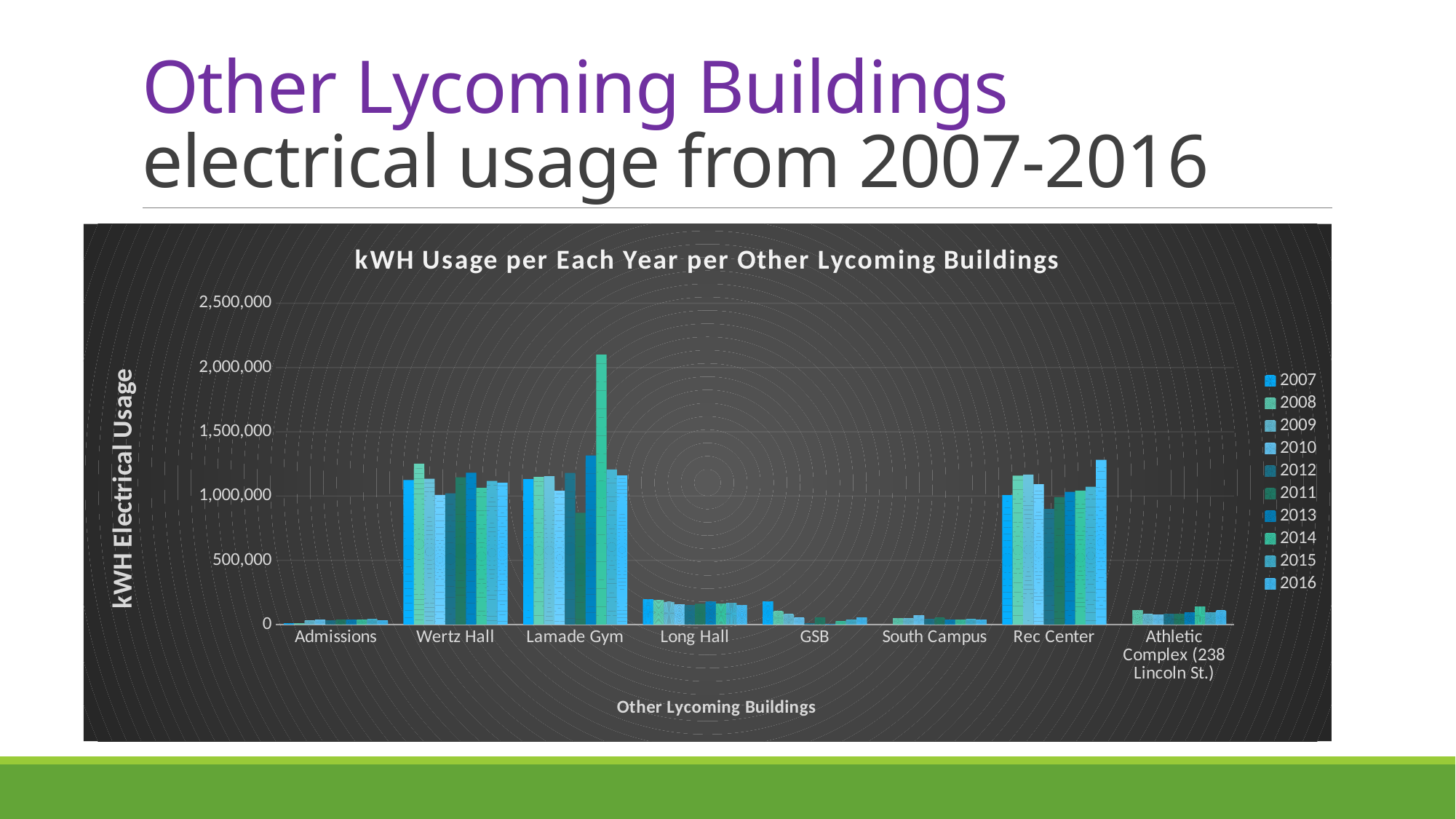
What is the label on the vertical axis of the chart? kWH Electrical Usage Is the value for Wertz Hall in 2008 greater or less than 1,000,000? greater Is the value for Admissions in 2007 greater or less than 500,000? less Is the value for Lamade Gym in 2014 greater or less than 2,000,000? greater Which year has the tallest bar for Lamade Gym? 2014 How many buildings are shown along the x axis of the chart? 8 Which building has the higher electrical usage in 2007, Wertz Hall or Long Hall? Wertz Hall How many years does the chart's legend list? 10 What is the title of the chart? kWH Usage per Each Year per Other Lycoming Buildings What kind of chart is shown on the slide? Bar chart Which building has the single tallest bar in the chart? Lamade Gym